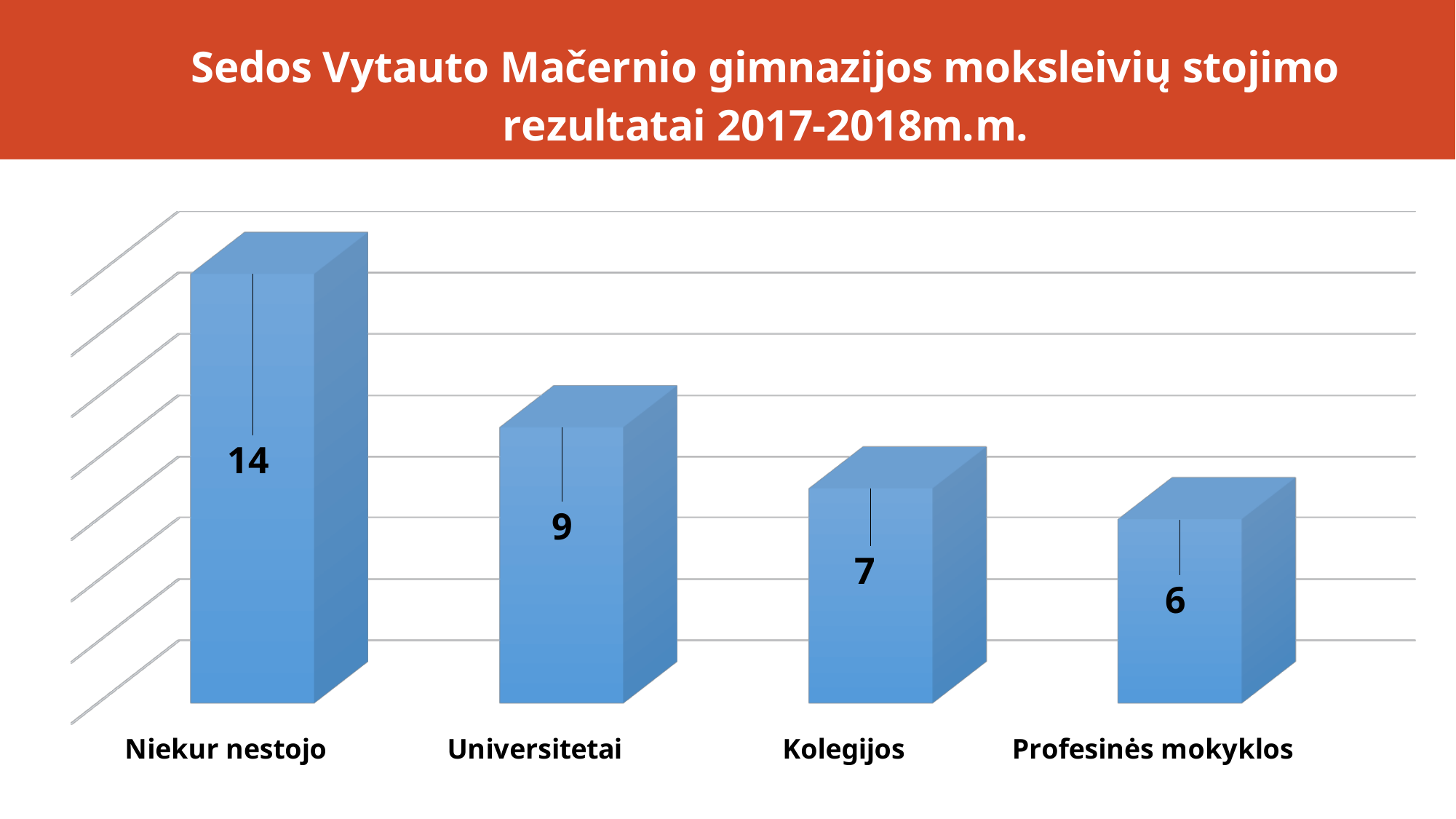
What is the value for Kolegijos? 7 Which category has the highest value? Niekur nestojo What is the difference between the values for Niekur nestojo and Universitetai? 5 Which category has the lowest value? Profesinės mokyklos What is the value for Universitetai? 9 What is the value for Niekur nestojo? 14 What kind of chart is shown on the slide? Bar chart What is the value for Profesinės mokyklos? 6 What is the difference between the values for Kolegijos and Profesinės mokyklos? 1 How many categories are shown in the chart? 4 Which is larger, the value for Universitetai or the value for Kolegijos? Universitetai Do the values rise or fall from left to right along the x axis? Fall